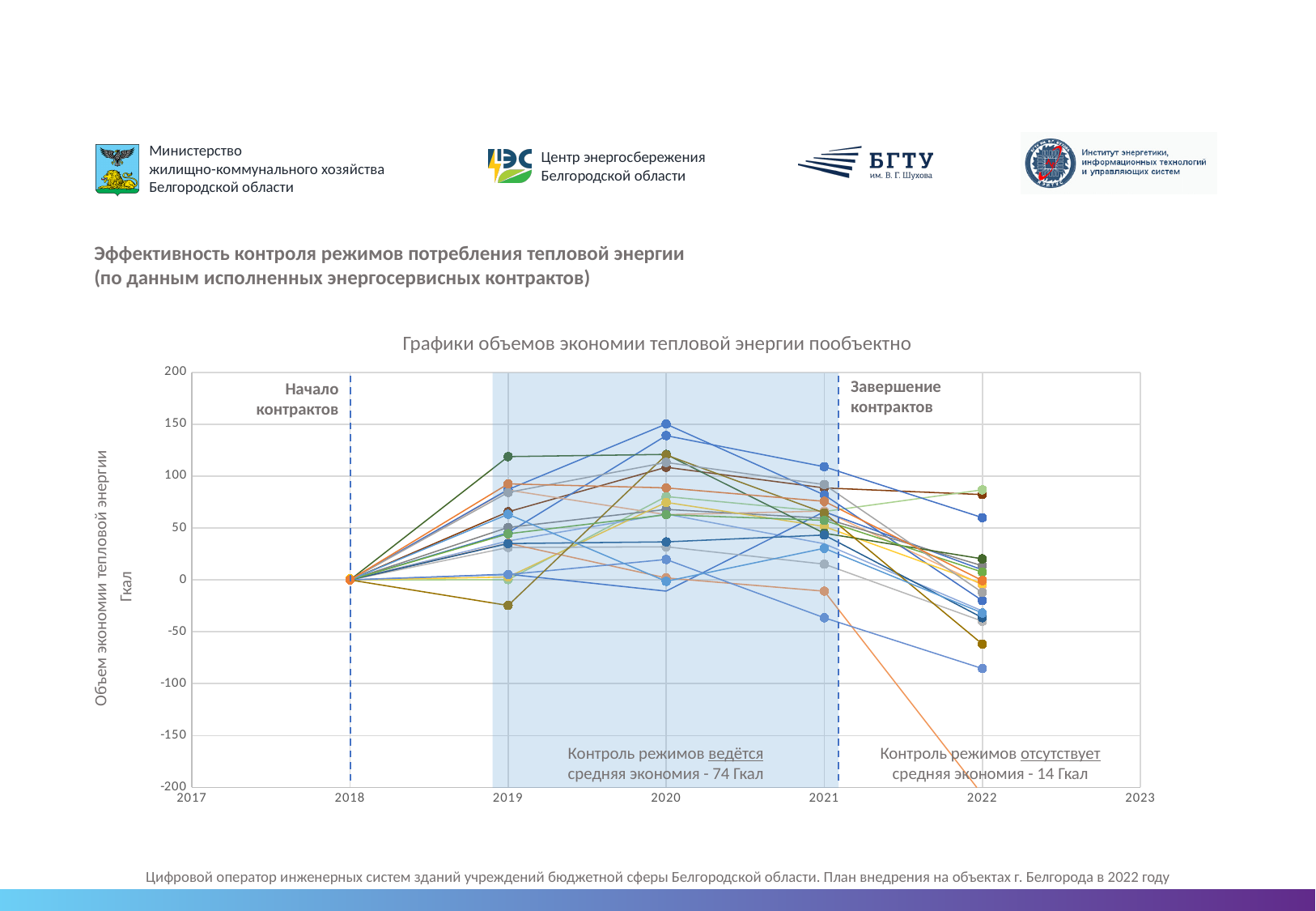
Do most of the lines rise or fall between 2021 and 2022? fall What is the title of the chart? Графики объемов экономии тепловой энергии пообъектно What value do all the lines share at 2018? 0 What unit is shown on the y axis of the chart? Гкал According to the annotation, what is the average saving during the period when regime control is carried out (Контроль режимов ведётся)? 74 Гкал According to the annotation, what is the average saving during the period when regime control is absent (Контроль режимов отсутствует)? 14 Гкал By how much does the average saving with regime control (74 Гкал) exceed the average saving without it (14 Гкал)? 60 Гкал Is the highest value plotted for 2019 greater or less than 100? greater How many year ticks are labelled on the x axis? 7 Is the highest value plotted for 2020 greater or less than 100? greater What kind of chart is shown on the slide? line chart Is the lowest value plotted for 2022 greater or less than -50? less